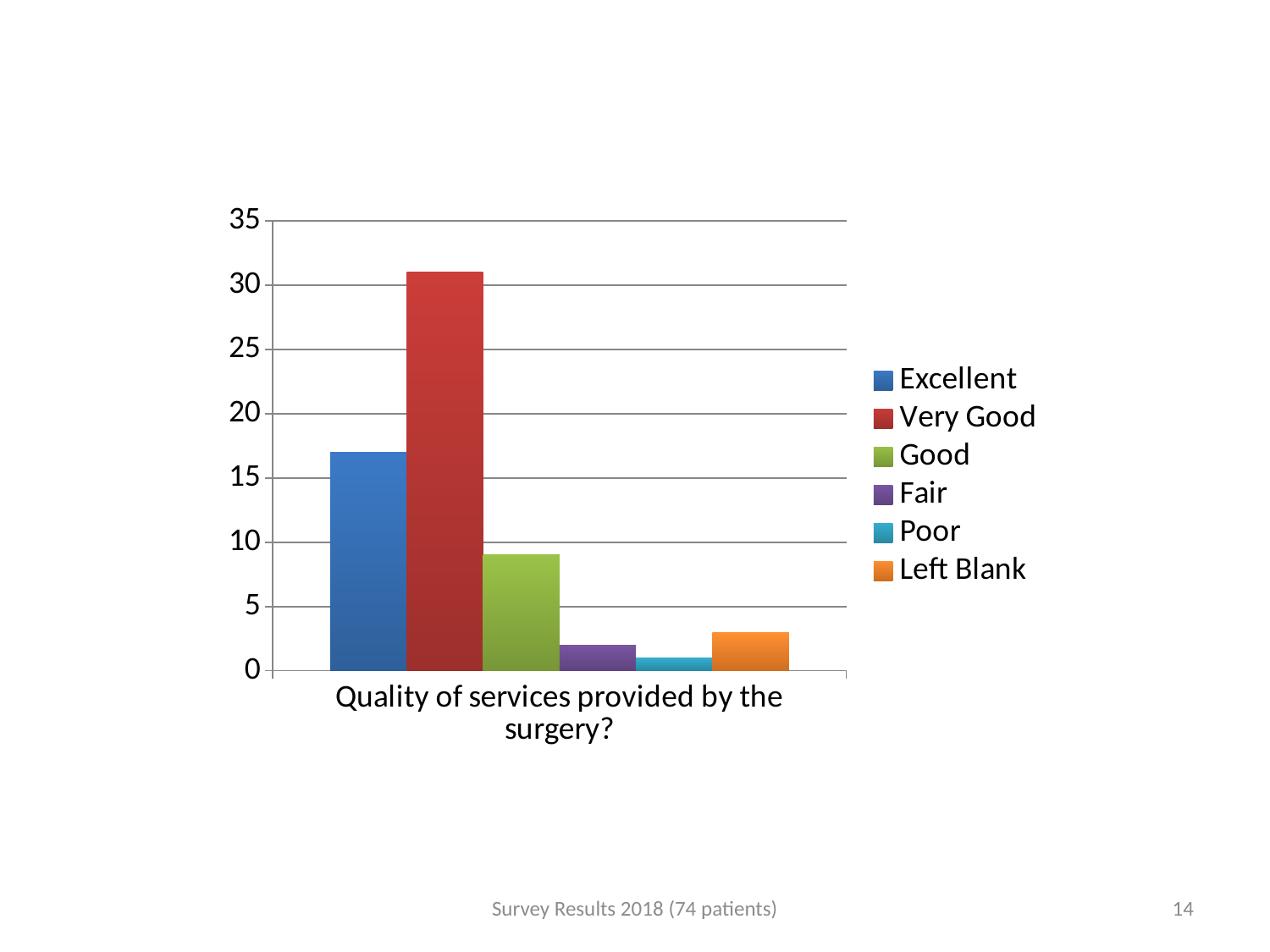
What kind of chart is shown on the slide? bar chart Which is larger, the bar for Left Blank or the bar for Fair? Left Blank What is the category label shown on the x axis? Quality of services provided by the surgery? How many series does the legend list? 6 Is the value for Good greater or less than 10? less Is the value for Excellent greater or less than 15? greater Which response has the lowest bar? Poor What colour is the bar for Very Good? red Which is larger, the bar for Excellent or the bar for Good? Excellent Is the value for Very Good greater or less than 30? greater Which response has the highest bar? Very Good